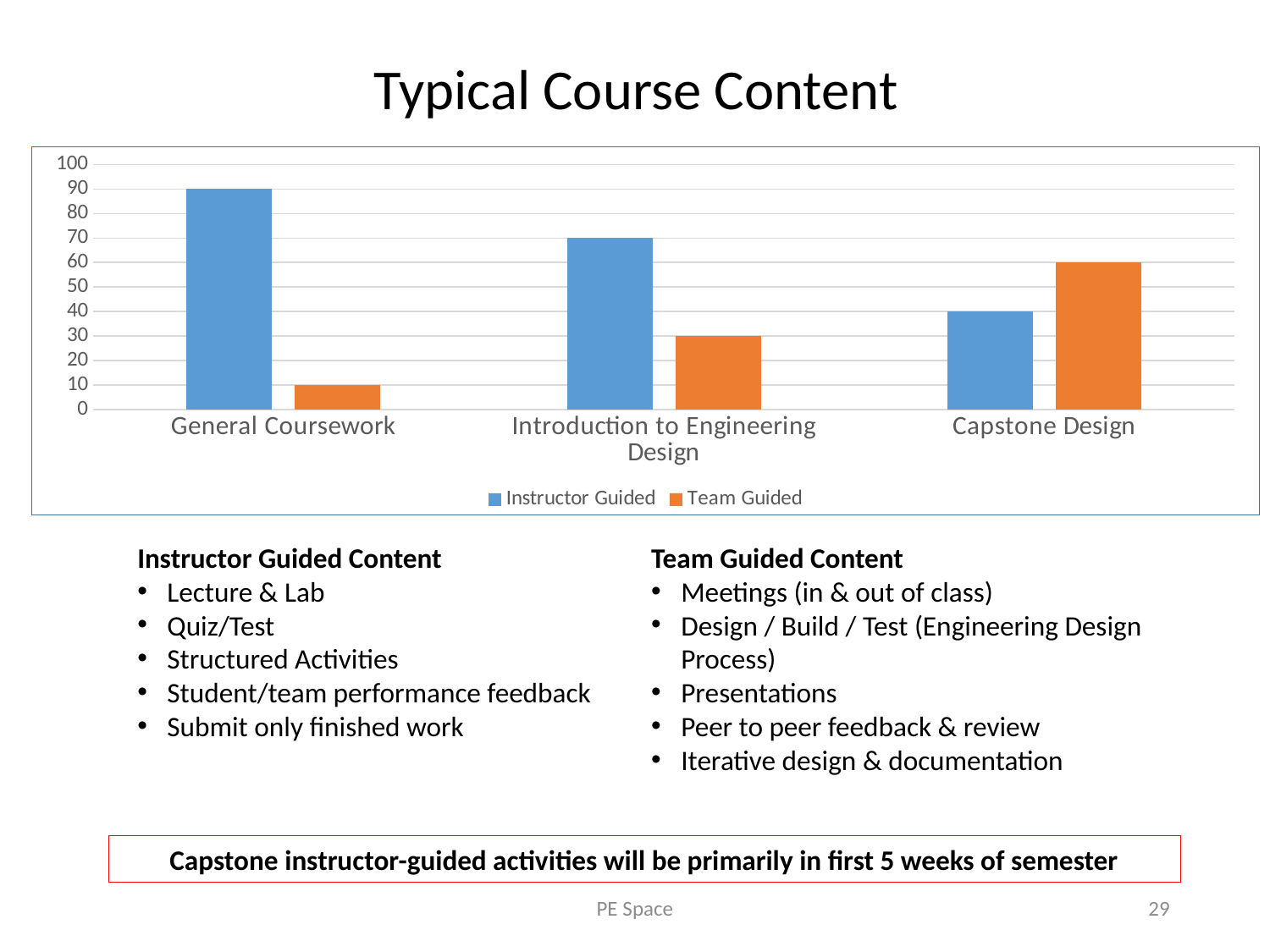
Which category has the lowest Team Guided value? General Coursework How many categories are shown on the x axis of the chart? 3 Does the Instructor Guided value fall or rise across the categories from left to right? fall How many series does the chart legend list? 2 What is the Team Guided value for Capstone Design? 60 For Capstone Design, which is larger: Instructor Guided or Team Guided? Team Guided What is the difference between the Instructor Guided and Team Guided values for General Coursework? 80 What kind of chart is shown on the slide? bar chart Which colour represents the Team Guided series in the chart? orange What is the Instructor Guided value for General Coursework? 90 What is the Instructor Guided value for Introduction to Engineering Design? 70 Which category has the highest Instructor Guided value? General Coursework